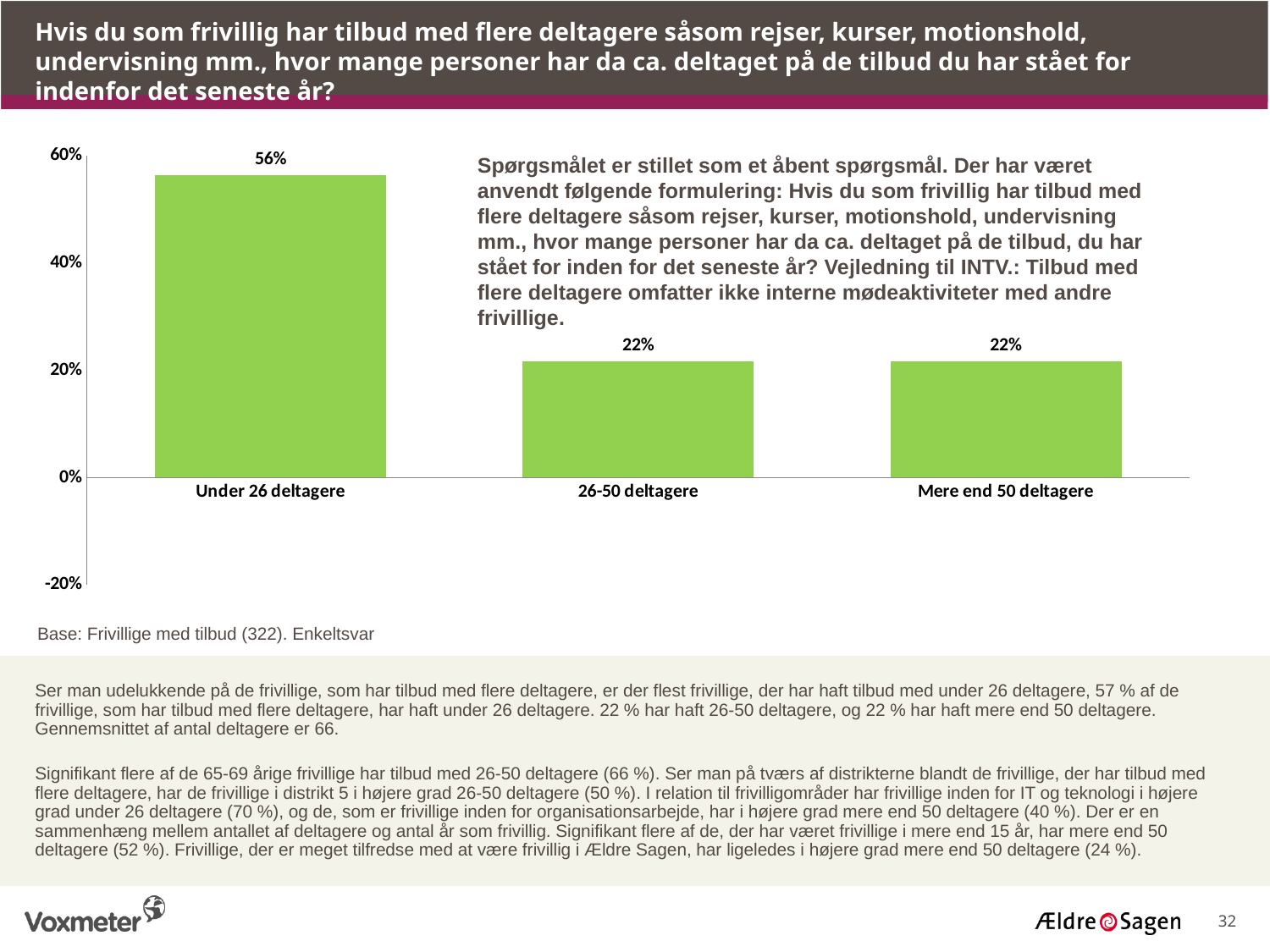
Which is larger, the value for "Under 26 deltagere" or the value for "Mere end 50 deltagere"? Under 26 deltagere Which category has the highest value? Under 26 deltagere What colour are the bars in the chart? Green Is the value for "Under 26 deltagere" greater or less than 40%? greater What is the difference between the values for "Under 26 deltagere" and "26-50 deltagere"? 34 percentage points What is the value for "26-50 deltagere"? 22% Is the value for "26-50 deltagere" greater or less than 40%? less What is the value for "Under 26 deltagere"? 56% What is the lowest value shown on the vertical axis? -20% What is the value for "Mere end 50 deltagere"? 22% What kind of chart is shown on the slide? Bar chart How many categories are shown on the chart? 3